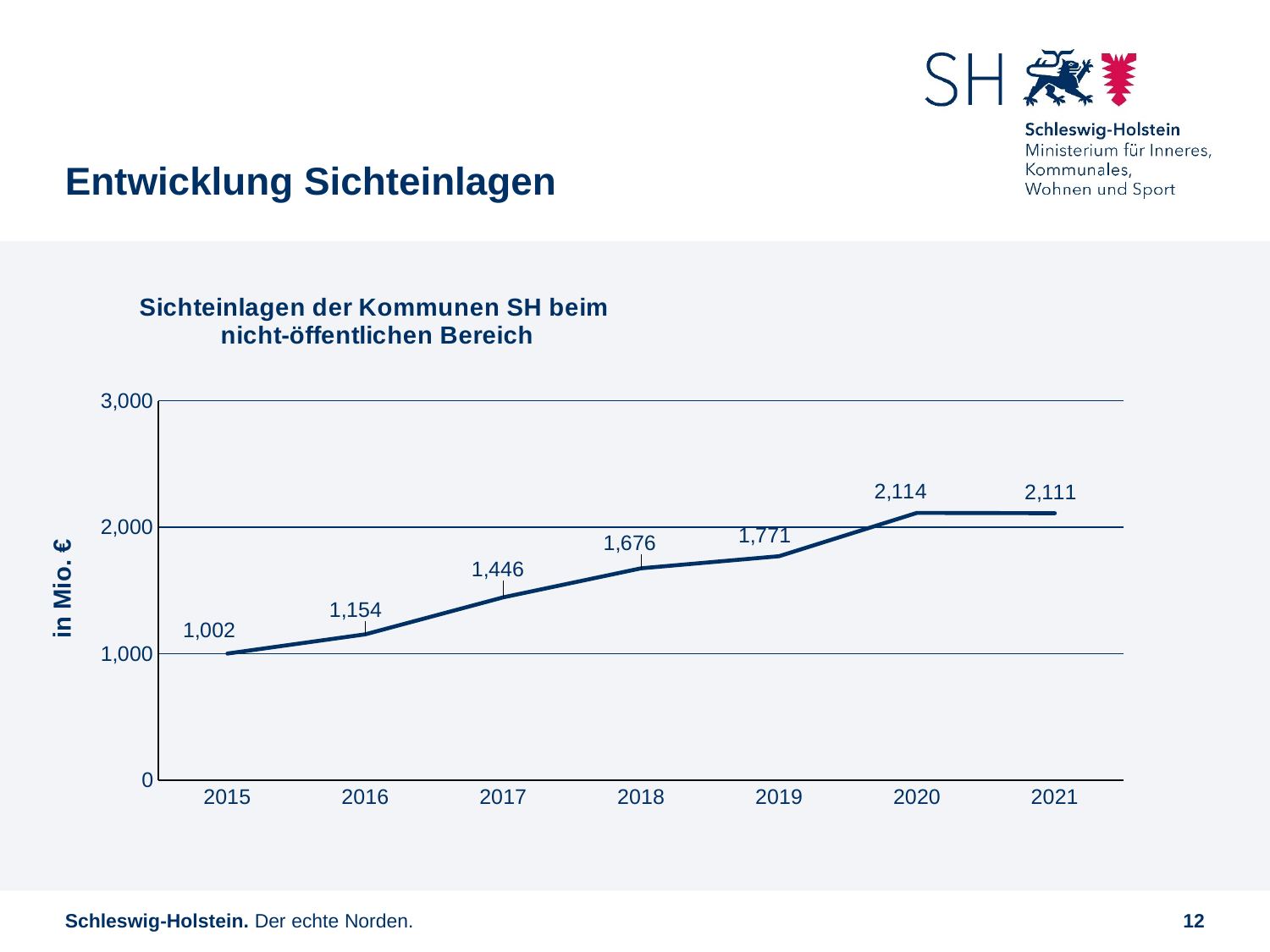
What is the value for 2021? 2,111 How many years are plotted on the x axis? 7 What is the value for 2015? 1,002 Which is larger, the value for 2017 or the value for 2016? 2017 What kind of chart is shown? line chart What is the value for 2018? 1,676 What is the unit shown on the y axis label? in Mio. € Which year has the lowest value? 2015 Is the value for 2019 greater or less than 2,000? less What is the difference between the values for 2020 and 2015? 1,112 Which year has the highest value? 2020 What is the difference between the values for 2019 and 2018? 95